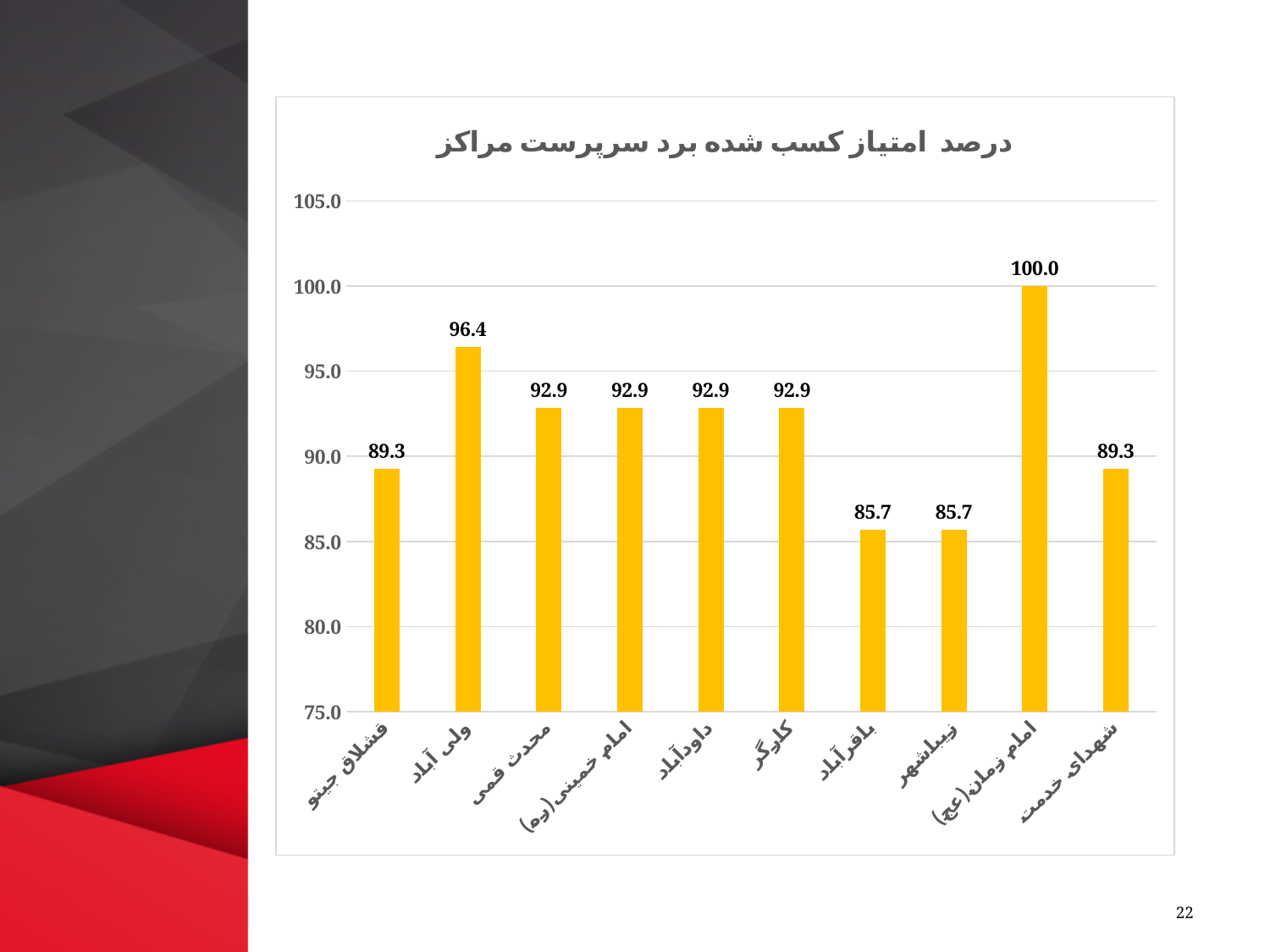
What is the difference between the values for محدث قمی and باقرآباد? 7.2 Which is larger, the value for کارگر or the value for قشلاق جیتو? کارگر What type of chart is shown on the slide? bar chart Which category has the highest value? امام زمان(عج) How many bars (categories) are shown in the chart? 10 What is the value for ولی آباد? 96.4 What is the title of the chart? درصد امتیاز کسب شده برد سرپرست مراکز What is the difference between the values for امام زمان(عج) and ولی آباد? 3.6 What is the value for امام زمان(عج)? 100.0 Is the value for داودآباد greater or less than 90.0? greater What is the value for باقرآباد? 85.7 What is the value for شهدای خدمت? 89.3